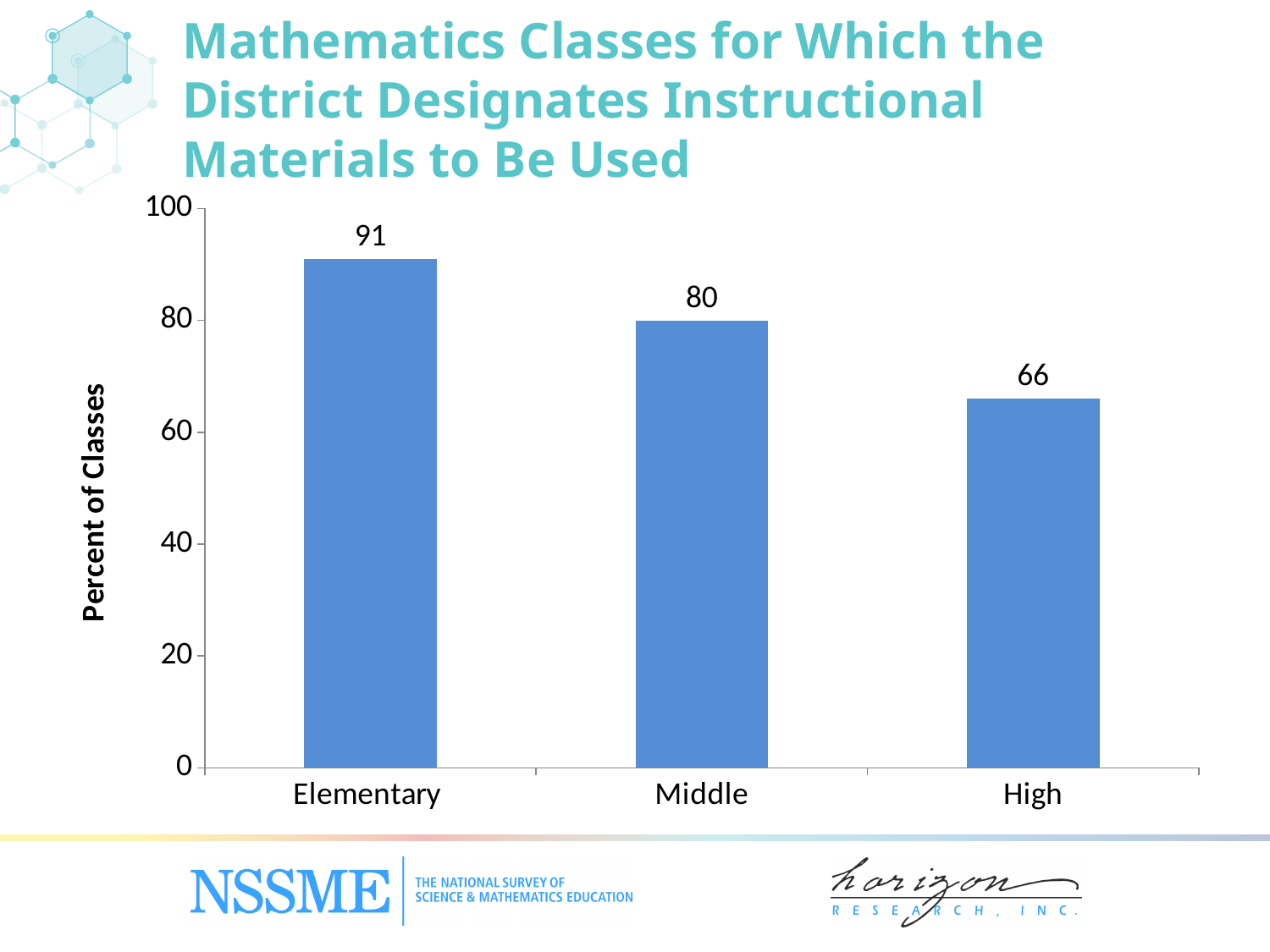
Do the values rise or fall from Elementary to High along the x axis? fall Which category has the lowest value? High What is the value for Middle? 80 What is the difference between the values for Middle and High? 14 Which category has the highest value? Elementary Is the value for High greater or less than 60? greater What kind of chart is shown on the slide? bar chart Which is larger, the value for Middle or the value for High? Middle What is the value for High? 66 How many categories are shown on the x axis? 3 What is the value for Elementary? 91 What is the difference between the values for Elementary and High? 25